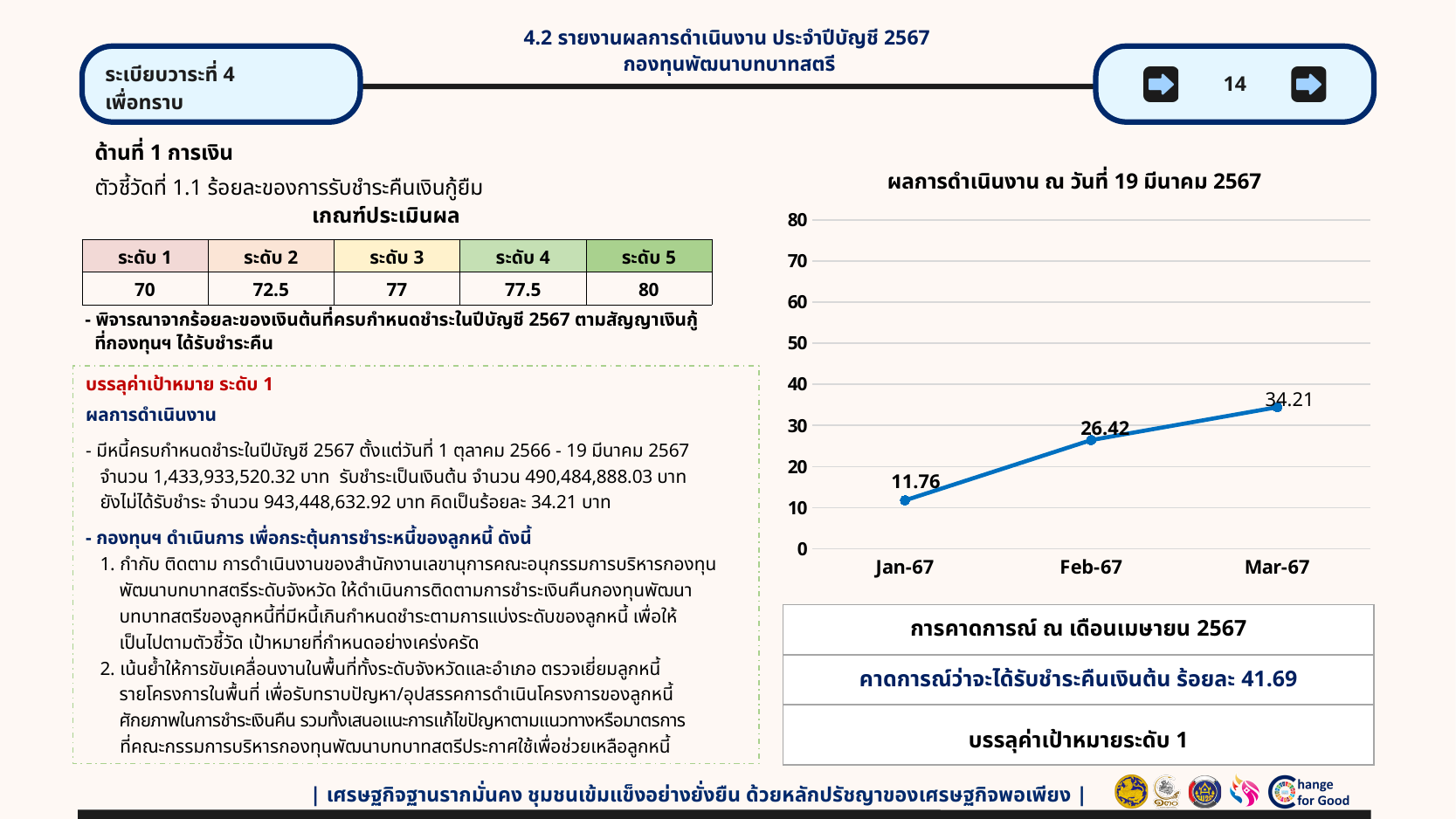
What is the difference between the values for Feb-67 and Jan-67? 14.66 How many data points are plotted on the line chart? 3 What is the value for Feb-67 in the line chart? 26.42 What type of chart is shown on the slide? line chart Is the value for Mar-67 greater or less than 40? less What is the difference between the values for Mar-67 and Jan-67? 22.45 Which month has the lowest value in the line chart? Jan-67 What is the value for Jan-67 in the line chart? 11.76 Which is larger, the value for Feb-67 or the value for Mar-67? Mar-67 Which month has the highest value in the line chart? Mar-67 Do the values rise or fall from Jan-67 to Mar-67? rise What is the value for Mar-67 in the line chart? 34.21